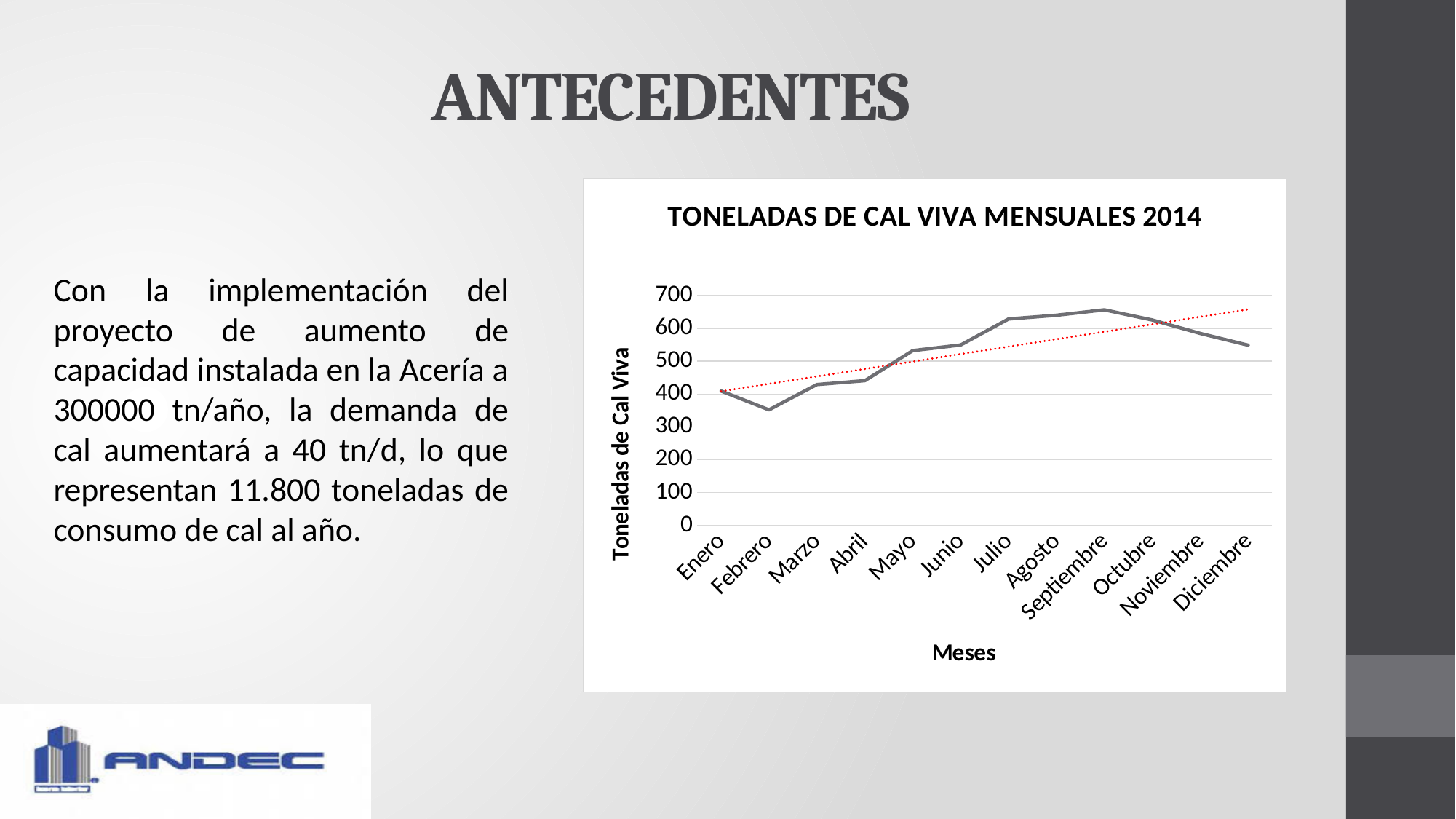
Is the value for Diciembre greater or less than 600? less Which month has the highest value in the chart? Septiembre Is the value for Febrero greater or less than 400? less Which month has the lowest value in the chart? Febrero Which month has the larger value, Marzo or Julio? Julio How many months are plotted along the x axis of the chart? 12 Do the values rise or fall from Septiembre to Diciembre? fall Is the value for Abril greater or less than 500? less What kind of chart is shown on the slide? line chart What is the title of the chart? TONELADAS DE CAL VIVA MENSUALES 2014 What is the label of the vertical axis of the chart? Toneladas de Cal Viva